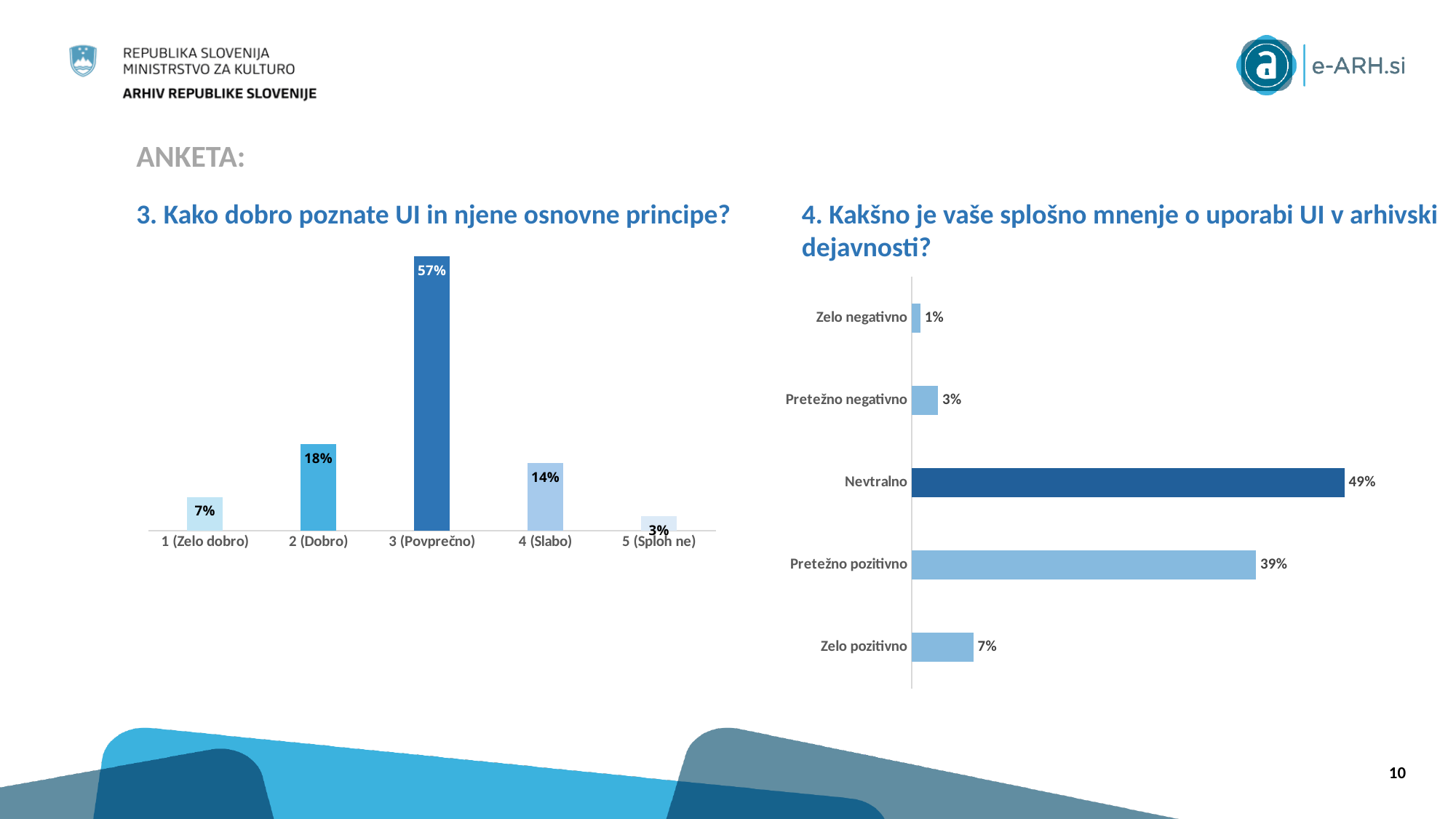
In the left chart (question 3), which is larger, '1 (Zelo dobro)' or '4 (Slabo)'? 4 (Slabo) In the right chart (question 4), what is the combined value of 'Zelo negativno' and 'Pretežno negativno'? 4% In the left chart (question 3), what is the value for '2 (Dobro)'? 18% In the left chart (question 3), what is the difference between '2 (Dobro)' and '4 (Slabo)'? 4% In the right chart (question 4, 'Kakšno je vaše splošno mnenje o uporabi UI v arhivski dejavnosti?'), what is the value for 'Nevtralno'? 49% In the right chart (question 4), which category has the highest value? Nevtralno What type of chart is the right chart (question 4)? Bar chart In the left chart (question 3), which category has the lowest value? 5 (Sploh ne) In the left chart (question 3, 'Kako dobro poznate UI in njene osnovne principe?'), what is the value for '3 (Povprečno)'? 57% In the right chart (question 4), what is the value for 'Pretežno pozitivno'? 39% In the left chart (question 3), how many categories are shown? 5 In the right chart (question 4), what is the difference between 'Nevtralno' and 'Pretežno pozitivno'? 10%